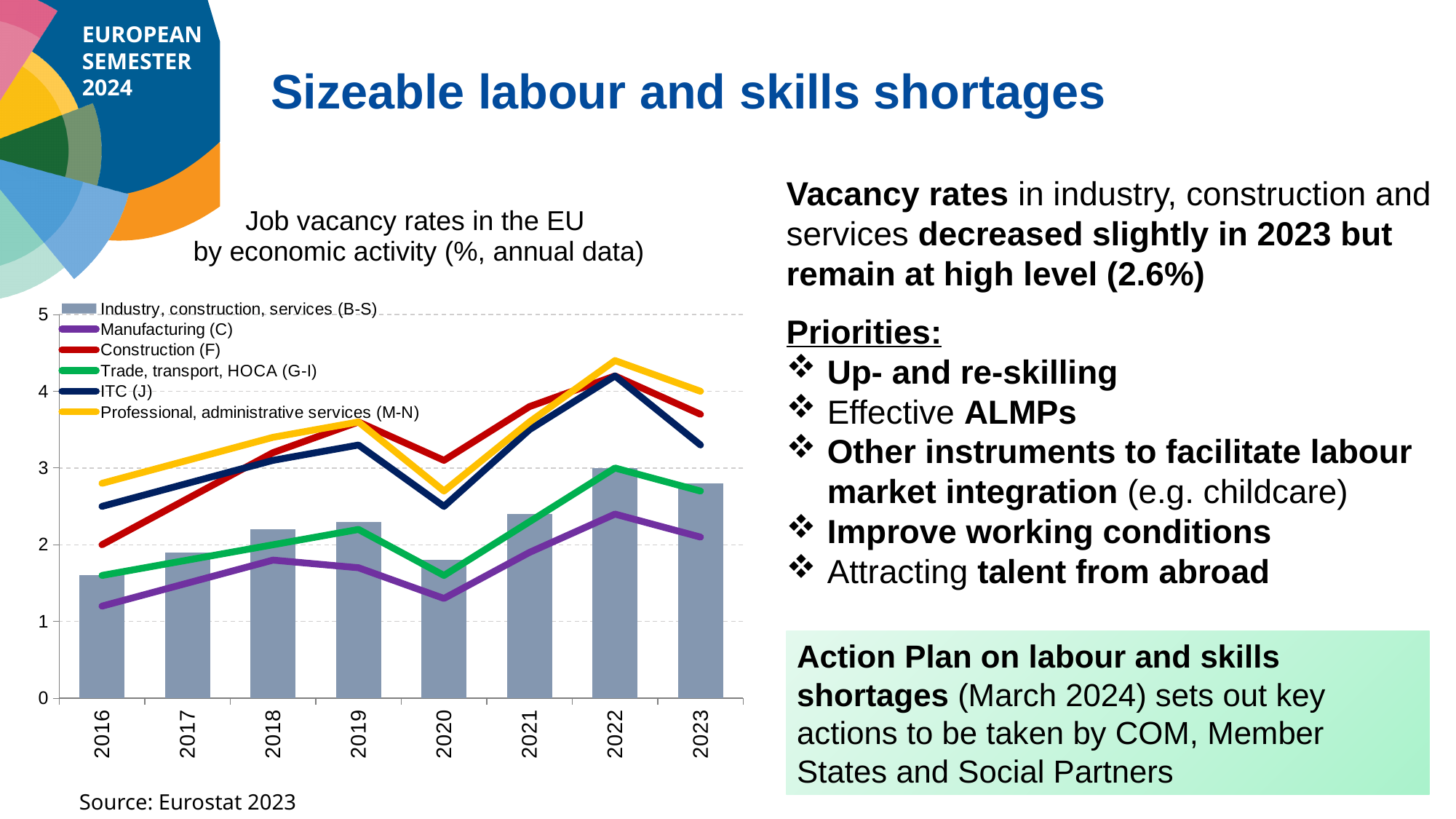
What is the source cited below the chart? Eurostat 2023 Is the bar value for Industry, construction, services (B-S) in 2016 greater or less than 2? less Is the value for Manufacturing (C) in 2020 greater or less than 2? less Do the bars for Industry, construction, services (B-S) rise or fall from 2016 to 2019? rise What kind of chart is shown on the slide? A combined bar and line chart In which year is the bar for Industry, construction, services (B-S) lowest? 2016 How many series does the chart legend list? 6 Is the value for Professional, administrative services (M-N) in 2022 greater or less than 4? greater In which year is the bar for Industry, construction, services (B-S) highest? 2022 Which series has the lowest values across the whole period? Manufacturing (C) How many years are shown on the x axis of the chart? 8 Which is larger, the bar for Industry, construction, services (B-S) in 2021 or in 2020? 2021